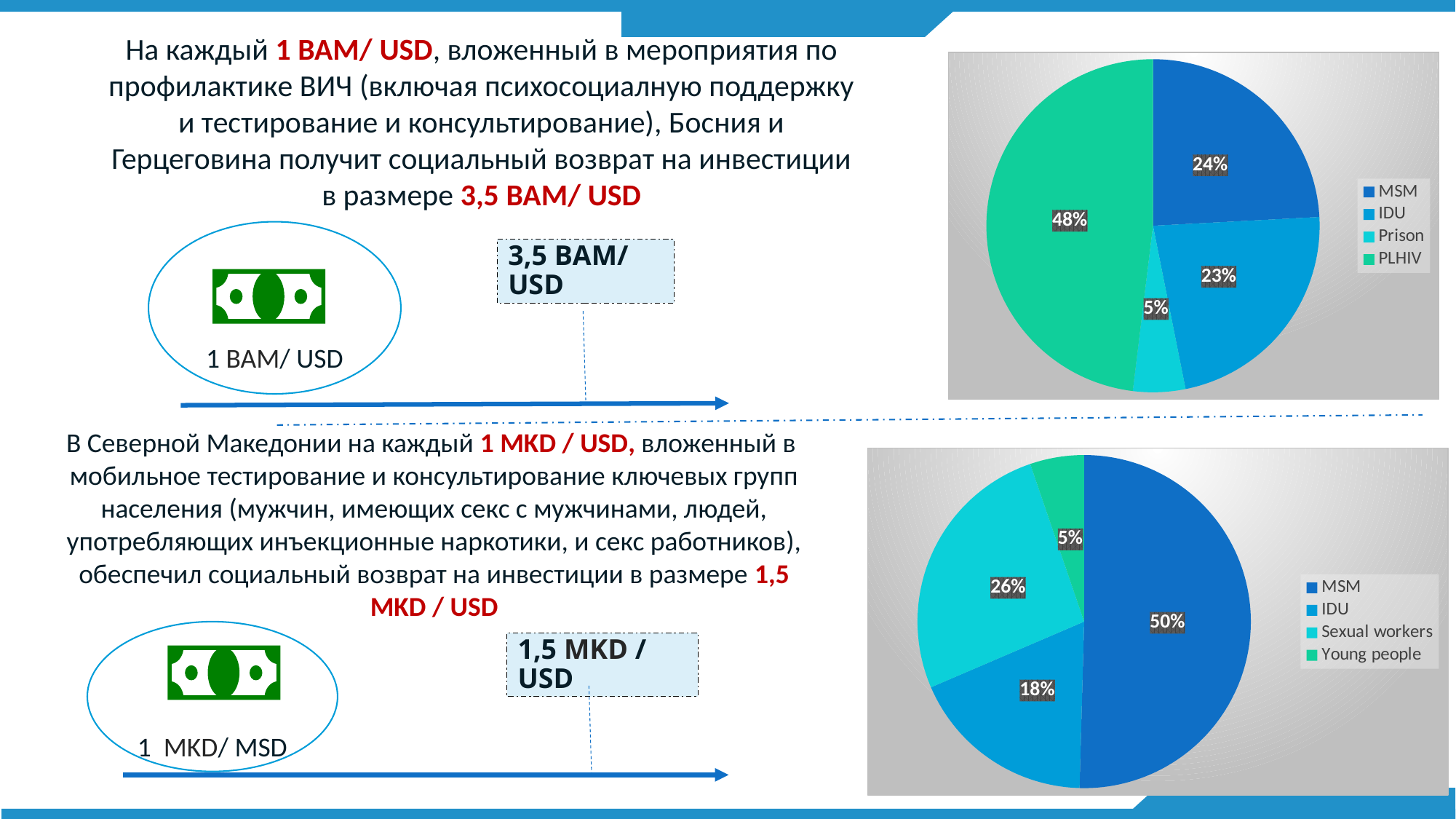
In the top-right pie chart, which category has the smallest share? Prison In the top-right pie chart, what is the difference between the MSM share and the IDU share? 1% In the bottom-right pie chart, which is larger, the share for IDU or the share for Sexual workers? Sexual workers In the bottom-right pie chart, what is the difference between the MSM share and the IDU share? 32% In the bottom-right pie chart, what share does MSM have? 50% In the bottom-right pie chart, what share do Sexual workers have? 26% In the top-right pie chart, what share does PLHIV have? 48% What type of chart is shown in the top-right of the slide? pie chart How many categories does the legend of the top-right pie chart list? 4 In the bottom-right pie chart, which category has the smallest share? Young people In the top-right pie chart, which category has the largest share? PLHIV In the top-right pie chart, what share does Prison have? 5%